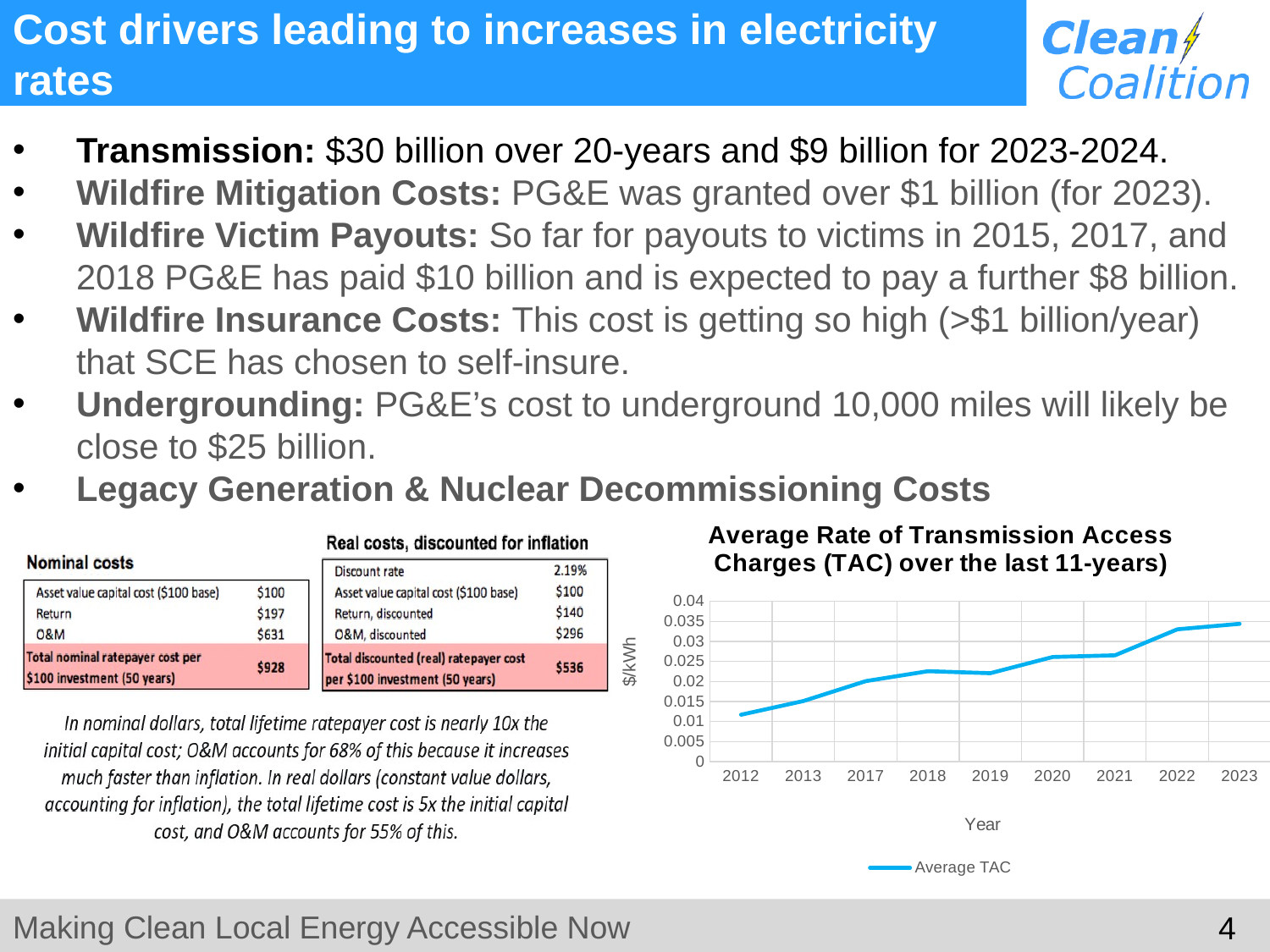
In the Average TAC chart, is the value for 2023 greater or less than 0.03? greater How many series does the legend of the Average TAC chart list? 1 How many years are plotted on the x axis of the Average TAC chart? 9 In the Average TAC chart, is the value for 2012 greater or less than 0.015? less In the Average TAC chart, is the value for 2018 greater or less than 0.025? less In the Average TAC chart, which year has the larger value, 2017 or 2022? 2022 In the Average TAC chart, which year has the highest value? 2023 What is the legend entry shown below the Average TAC chart? Average TAC What is the y-axis label of the Average TAC chart? $/kWh What kind of chart is the "Average Rate of Transmission Access Charges (TAC)" chart? Line chart In the Average TAC chart, which year has the lowest value? 2012 In the Average TAC chart, does the value generally rise or fall from 2012 to 2023? Rise